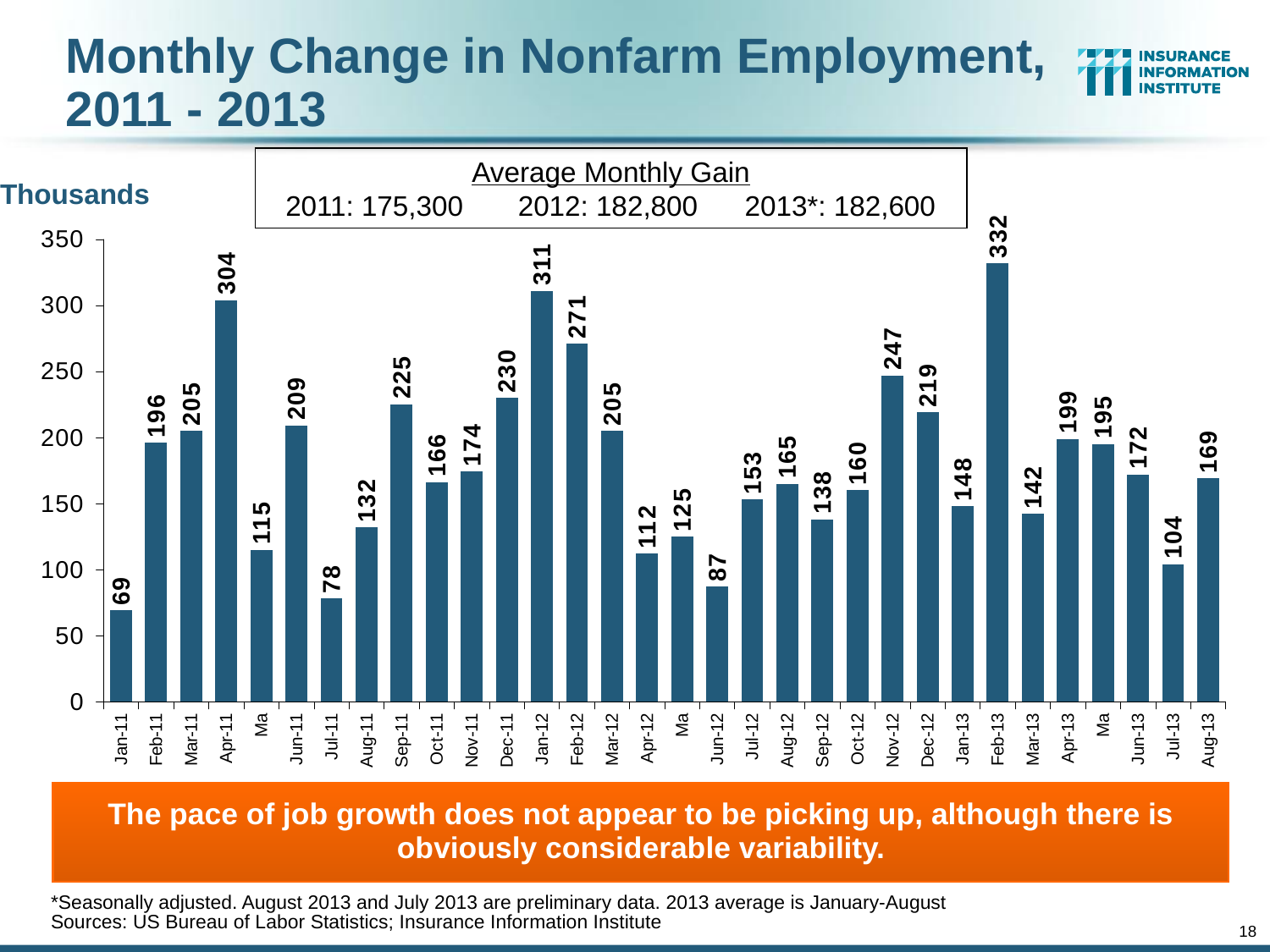
What is the value for Jul-13? 104 How many bars are plotted in the chart? 32 What is the value for Feb-13? 332 Do the values rise or fall from Jan-11 to Apr-11? rise What is the difference between the values for Jan-12 and Feb-12? 40 Which month has the lowest value? Jan-11 What unit is shown for the y axis of the chart? Thousands Which month has the highest value? Feb-13 Which is larger, the value for Apr-11 or the value for Jan-12? Jan-12 What kind of chart is shown on the slide? bar chart Is the value for Jun-12 greater or less than 100? less What is the value for Dec-11? 230